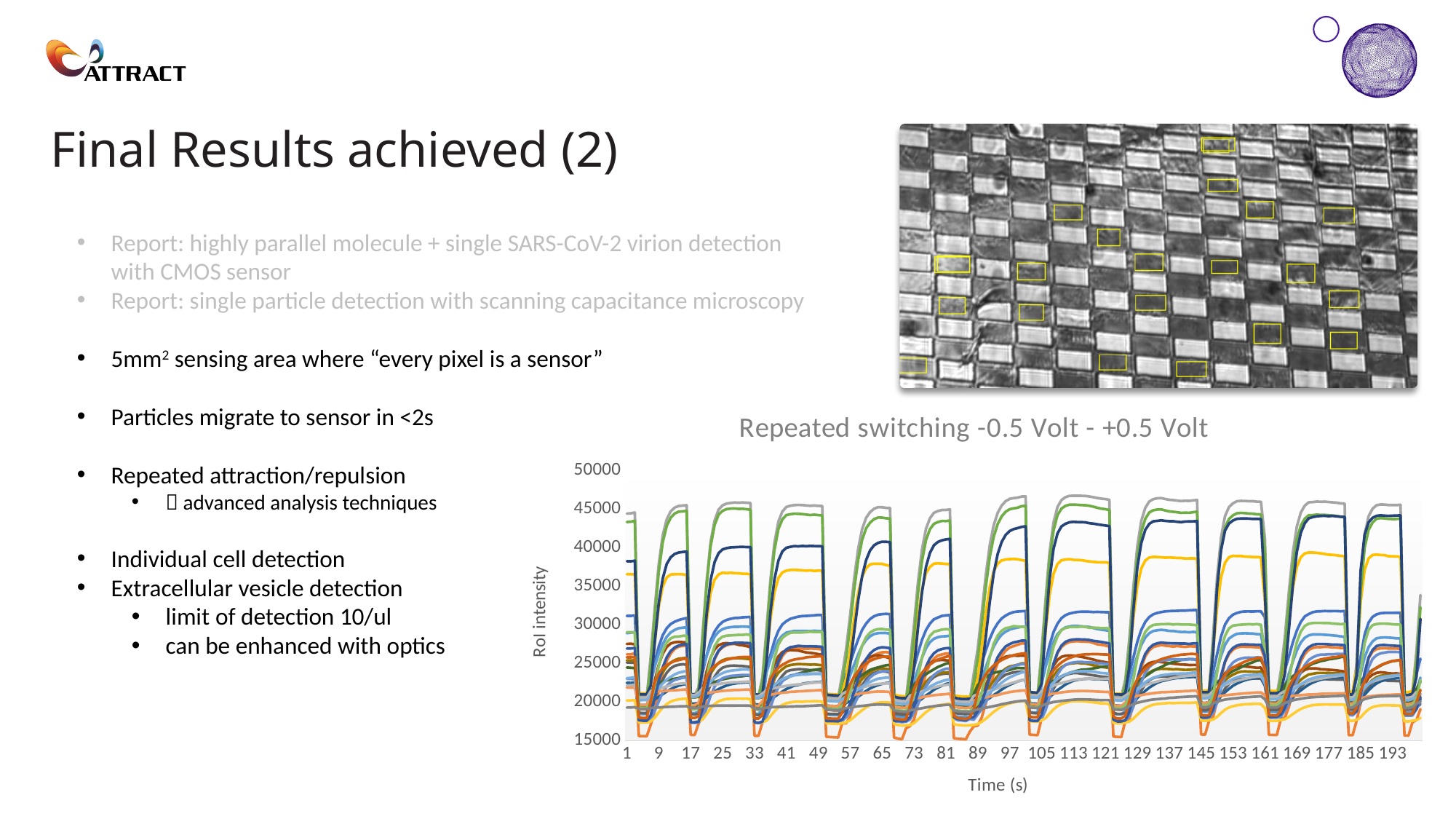
What is the lowest value shown on the y axis of the chart? 15000 What is the title of the chart on the slide? Repeated switching -0.5 Volt - +0.5 Volt What is the highest value shown on the y axis of the chart? 50000 What kind of chart is shown on the slide? line chart Is the lowest dip reached by any line in the chart greater or less than 20000? less Is the highest peak reached by any line in the chart greater or less than 40000? greater